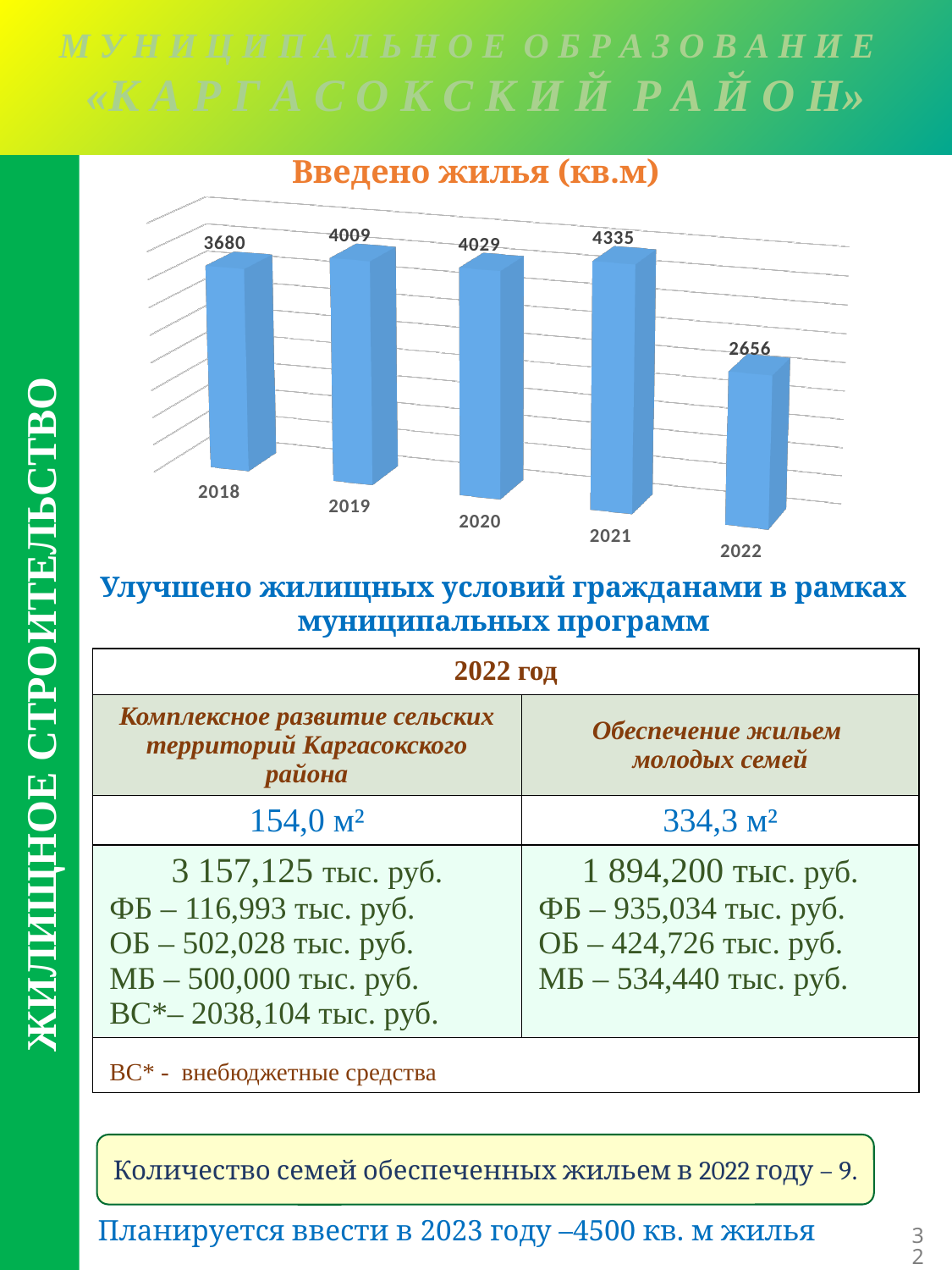
What is the value for 2018 in the chart "Введено жилья (кв.м)"? 3680 Which year has the highest value in the chart "Введено жилья (кв.м)"? 2021 What is the value for 2022 in the chart "Введено жилья (кв.м)"? 2656 What is the difference between the values for 2021 and 2022 in the chart "Введено жилья (кв.м)"? 1679 What kind of chart is "Введено жилья (кв.м)"? bar chart What is the value for 2021 in the chart "Введено жилья (кв.м)"? 4335 In the chart "Введено жилья (кв.м)", which is larger: the value for 2018 or the value for 2022? 2018 What is the difference between the values for 2019 and 2018 in the chart "Введено жилья (кв.м)"? 329 What is the title of the chart on the slide? Введено жилья (кв.м) How many years are shown in the chart "Введено жилья (кв.м)"? 5 What is the value for 2019 in the chart "Введено жилья (кв.м)"? 4009 Which year has the lowest value in the chart "Введено жилья (кв.м)"? 2022